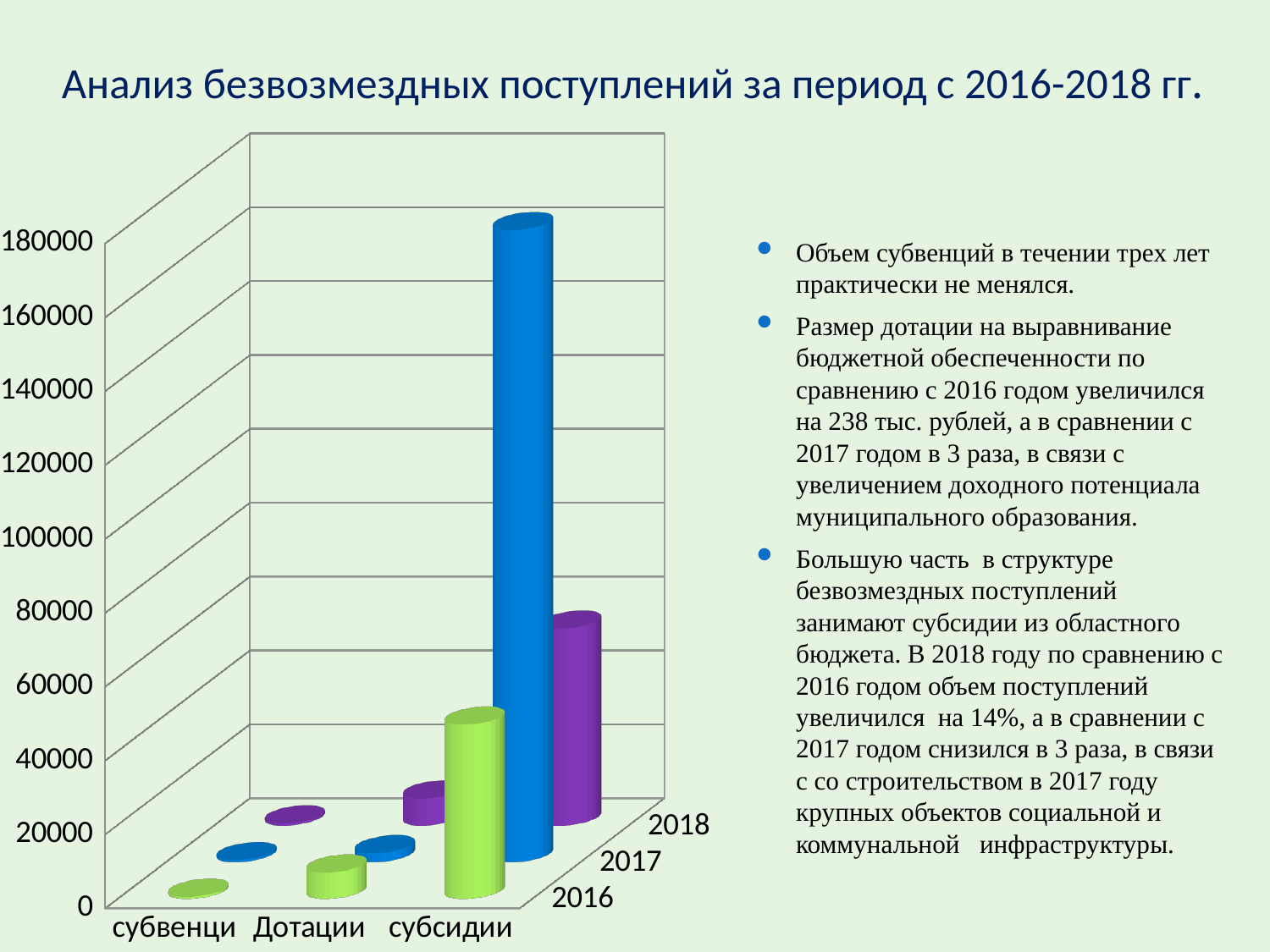
Which is larger, the value for субсидии in 2016 or the value for Дотации in 2016? субсидии in 2016 What kind of chart is shown on the slide? bar chart Which is larger, the value for субсидии in 2017 or the value for субсидии in 2018? субсидии in 2017 How many categories are shown on the horizontal axis of the chart? 3 What is the title of the slide? Анализ безвозмездных поступлений за период с 2016-2018 гг. Which category has the highest values across all three years? субсидии Which years are shown on the depth axis of the chart? 2016, 2017, 2018 Is the value for субвенци in 2016 greater or less than 20000? less Is the value for субсидии in 2017 greater or less than 140000? greater Is the value for субсидии in 2018 greater or less than 100000? less Which category and year has the highest bar in the chart? субсидии, 2017 What is the highest value shown on the vertical axis of the chart? 180000